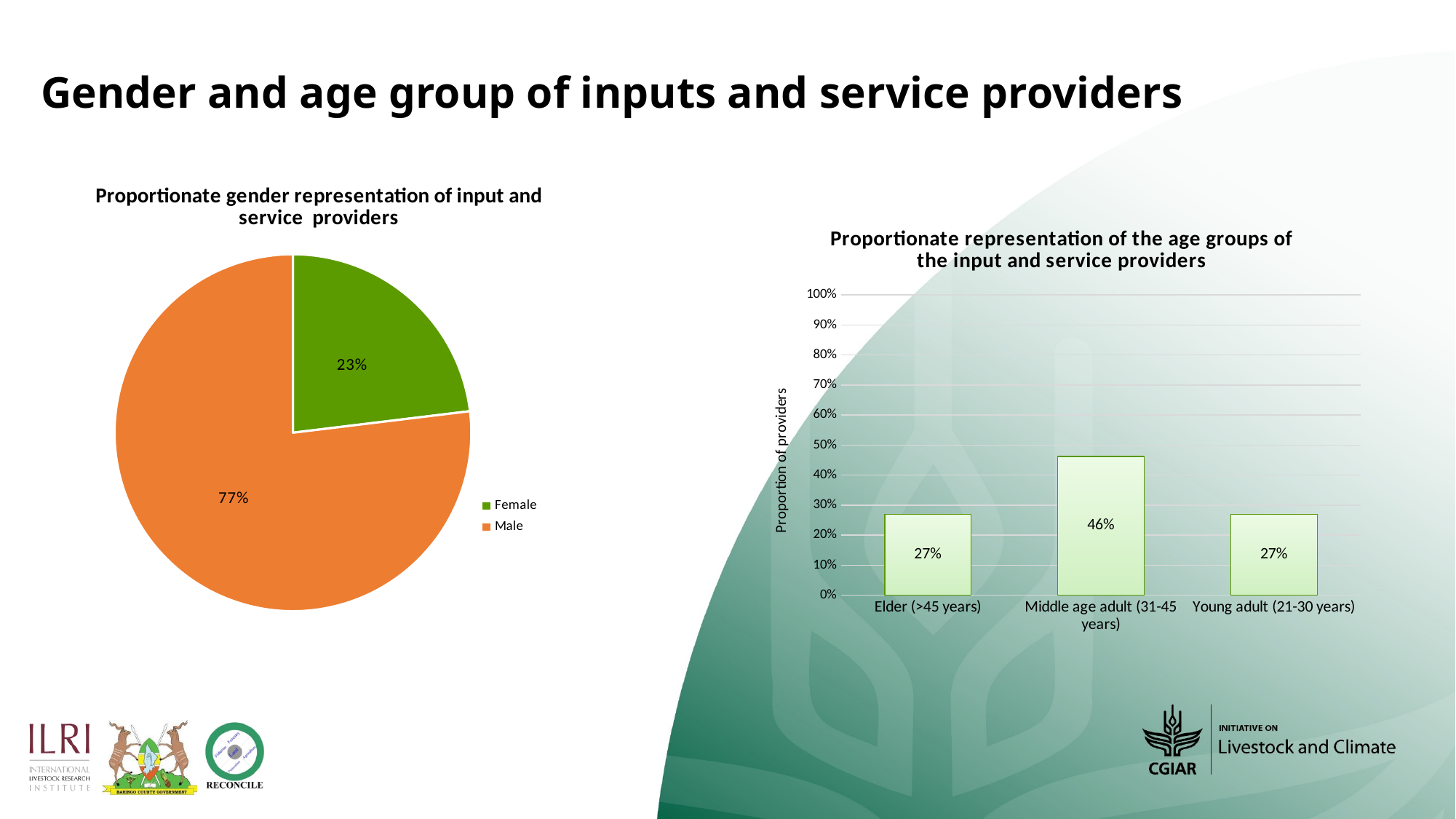
In the bar chart on the right, which age group has the highest proportion of providers? Middle age adult (31-45 years) In the bar chart on the right, what is the value for Elder (>45 years)? 27% In the bar chart on the right, what is the difference in percentage points between Middle age adult (31-45 years) and Young adult (21-30 years)? 19 In the pie chart on the left, how many slices are there? 2 In the bar chart on the right, how many age group categories are shown? 3 In the pie chart 'Proportionate gender representation of input and service providers', what share of providers is Female? 23% What type of chart is the chart on the left of the slide? Pie chart What type of chart is the chart on the right of the slide? Bar chart In the pie chart on the left, what is the difference in percentage points between the Male and Female shares? 54 In the pie chart 'Proportionate gender representation of input and service providers', what share of providers is Male? 77% In the pie chart on the left, which gender has the larger share? Male In the bar chart 'Proportionate representation of the age groups of the input and service providers', what is the value for Middle age adult (31-45 years)? 46%